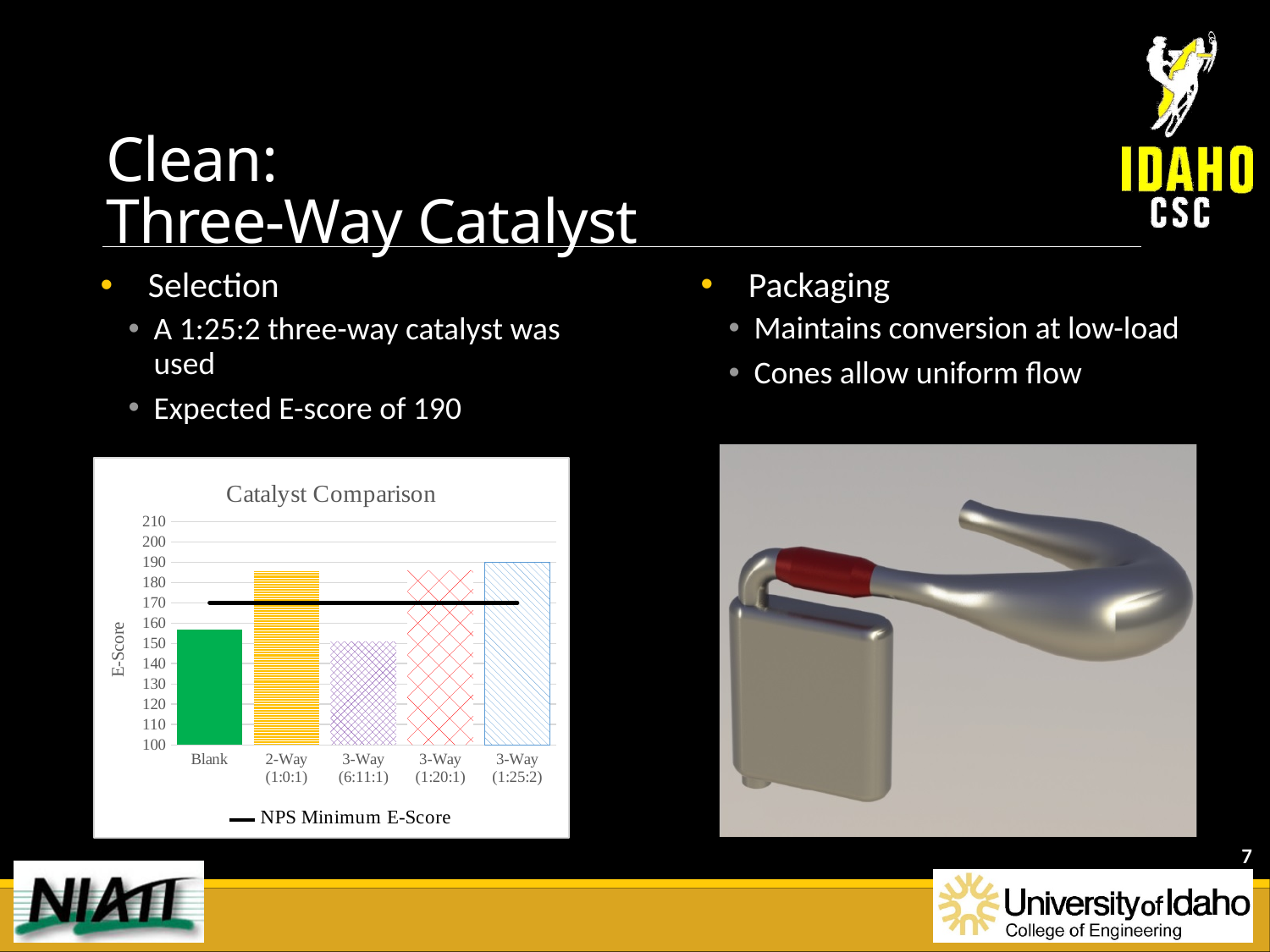
How many bars in the Catalyst Comparison chart are above the NPS Minimum E-Score line? 3 How many catalyst categories are shown on the x axis of the Catalyst Comparison chart? 5 What kind of chart is the Catalyst Comparison chart? bar chart Which catalyst has the highest E-Score in the Catalyst Comparison chart? 3-Way (1:25:2) In the Catalyst Comparison chart, which has the higher E-Score, Blank or 3-Way (1:20:1)? 3-Way (1:20:1) What is the E-Score for the 3-Way (1:25:2) catalyst in the Catalyst Comparison chart? 190 Is the E-Score for 3-Way (6:11:1) greater or less than 160 in the Catalyst Comparison chart? less What is the label of the y axis in the Catalyst Comparison chart? E-Score What is the title of the chart on the slide? Catalyst Comparison What value does the NPS Minimum E-Score line sit at in the Catalyst Comparison chart? 170 Is the E-Score for 2-Way (1:0:1) greater or less than 180 in the Catalyst Comparison chart? greater Is the E-Score for Blank greater or less than 170 in the Catalyst Comparison chart? less